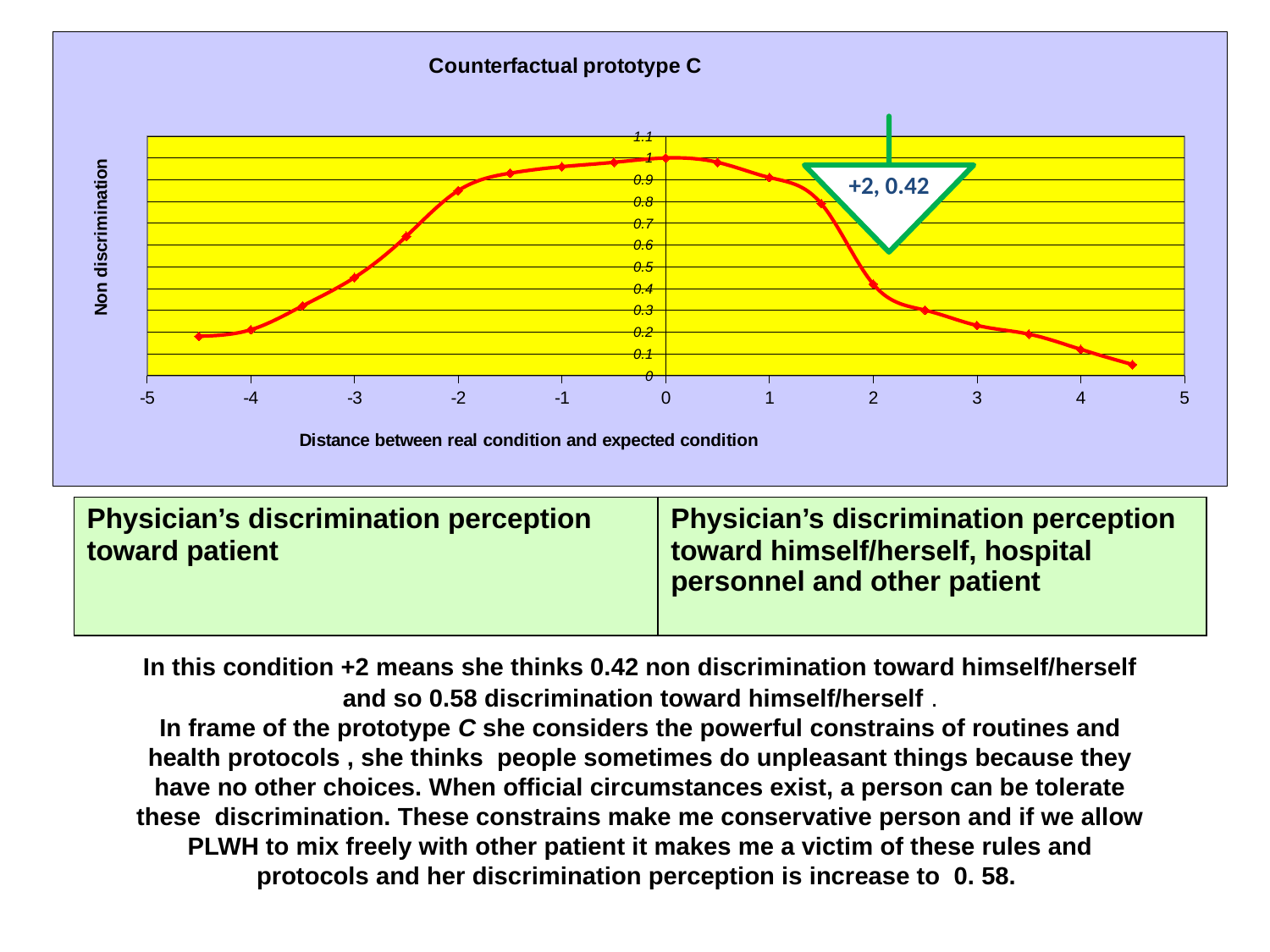
At which distance on the x axis is the Non discrimination value lowest? 4.5 Is the value at a distance of -2 greater or less than 0.5? greater What is the Non discrimination value at a distance of +2, as shown in the callout? 0.42 Is the value at a distance of -4 greater or less than 0.5? less What is the label of the x axis of the chart? Distance between real condition and expected condition Is the value at a distance of 0 greater or less than 0.5? greater Do the values rise or fall as the distance increases from 0 to 5? fall What is the title of the chart? Counterfactual prototype C What kind of chart is shown on the slide? line chart Which is larger, the value at a distance of -2 or the value at a distance of 2? -2 Do the values rise or fall as the distance increases from -5 to 0? rise